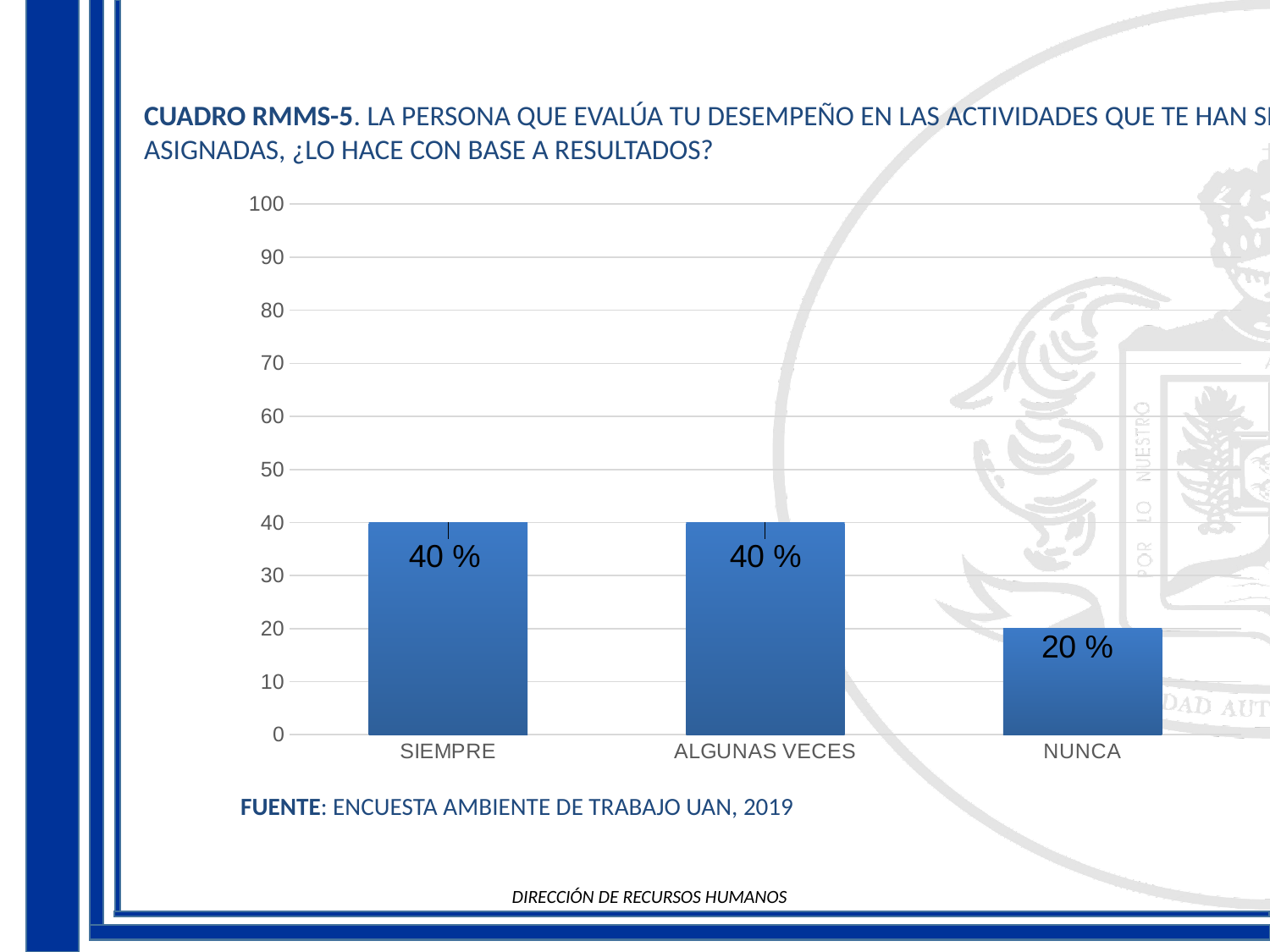
What is the highest value shown on the vertical axis? 100 How many categories are shown on the x axis? 3 What is the difference between the values for SIEMPRE and NUNCA? 20 % Which category has the lowest value? NUNCA Is the value for SIEMPRE greater or less than 50? less What kind of chart is shown on the slide? bar chart What is the value for ALGUNAS VECES? 40 % Is the value for NUNCA greater or less than 30? less What source is cited below the chart? ENCUESTA AMBIENTE DE TRABAJO UAN, 2019 What is the value for SIEMPRE? 40 % What is the value for NUNCA? 20 % Which is larger, the value for ALGUNAS VECES or the value for NUNCA? ALGUNAS VECES